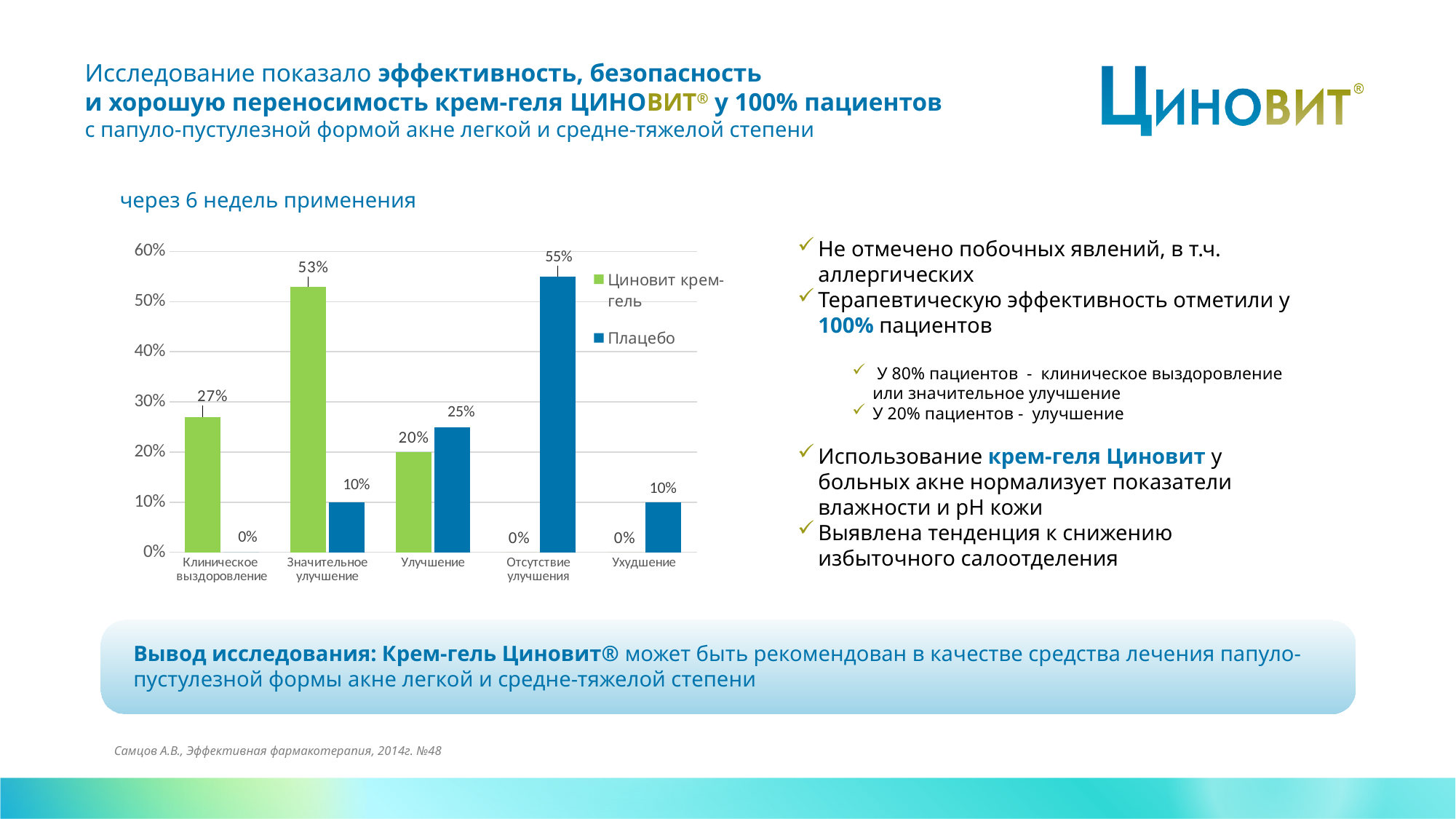
What is the text shown above the chart? через 6 недель применения How many categories are shown on the x axis? 5 What kind of chart is shown on the slide? Bar chart What is the value for Плацебо in the Отсутствие улучшения category? 55% What is the value for Плацебо in the Ухудшение category? 10% How many series does the legend list? 2 In the Улучшение category, which series has the larger value, Циновит крем-гель or Плацебо? Плацебо What is the value for Циновит крем-гель in the Клиническое выздоровление category? 27% Which category has the highest value for Плацебо? Отсутствие улучшения Which category has the highest value for Циновит крем-гель? Значительное улучшение What is the value for Циновит крем-гель in the Значительное улучшение category? 53% What is the difference between the Циновит крем-гель and Плацебо values in the Значительное улучшение category? 43%